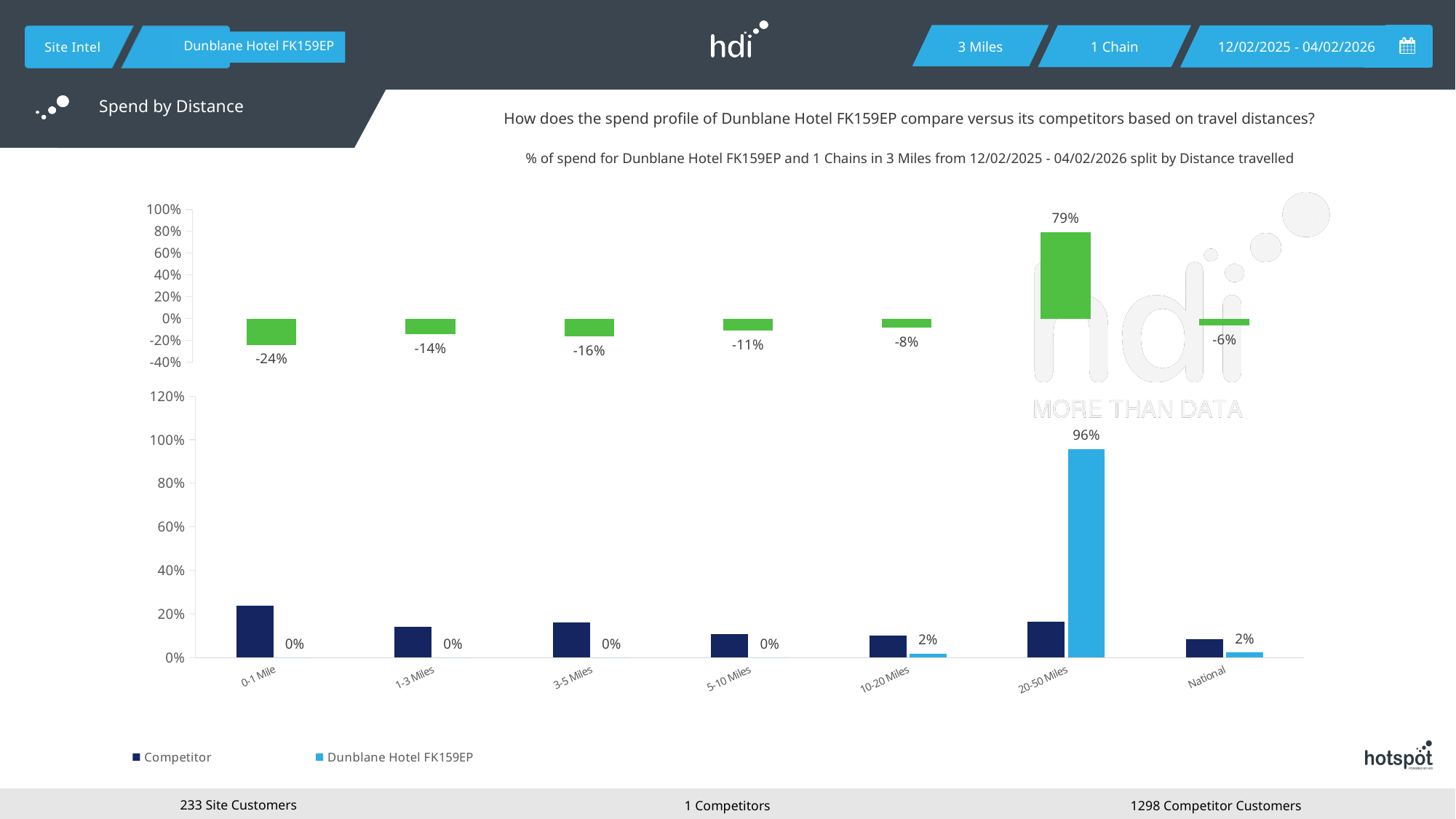
How many series does the legend of the bottom chart list? 2 How many categories are shown on the x axis of the bottom chart? 7 In the bottom chart, which is larger in the 20-50 Miles category: Competitor or Dunblane Hotel FK159EP? Dunblane Hotel FK159EP In the bottom chart, which category has the highest value for Dunblane Hotel FK159EP? 20-50 Miles In the top chart, what is the value of the first green bar on the left? -24% What kind of chart is the bottom chart? bar chart In the bottom chart, is the Competitor value for National greater or less than 20%? less In the top chart, what is the value of the sixth (tallest) green bar? 79% In the bottom chart, what is the value for Dunblane Hotel FK159EP in the 20-50 Miles category? 96% In the bottom chart, what is the value for Dunblane Hotel FK159EP in the 10-20 Miles category? 2% In the bottom chart, what is the value for Dunblane Hotel FK159EP in the 0-1 Mile category? 0% In the bottom chart, is the Competitor value for 0-1 Mile greater or less than 20%? greater